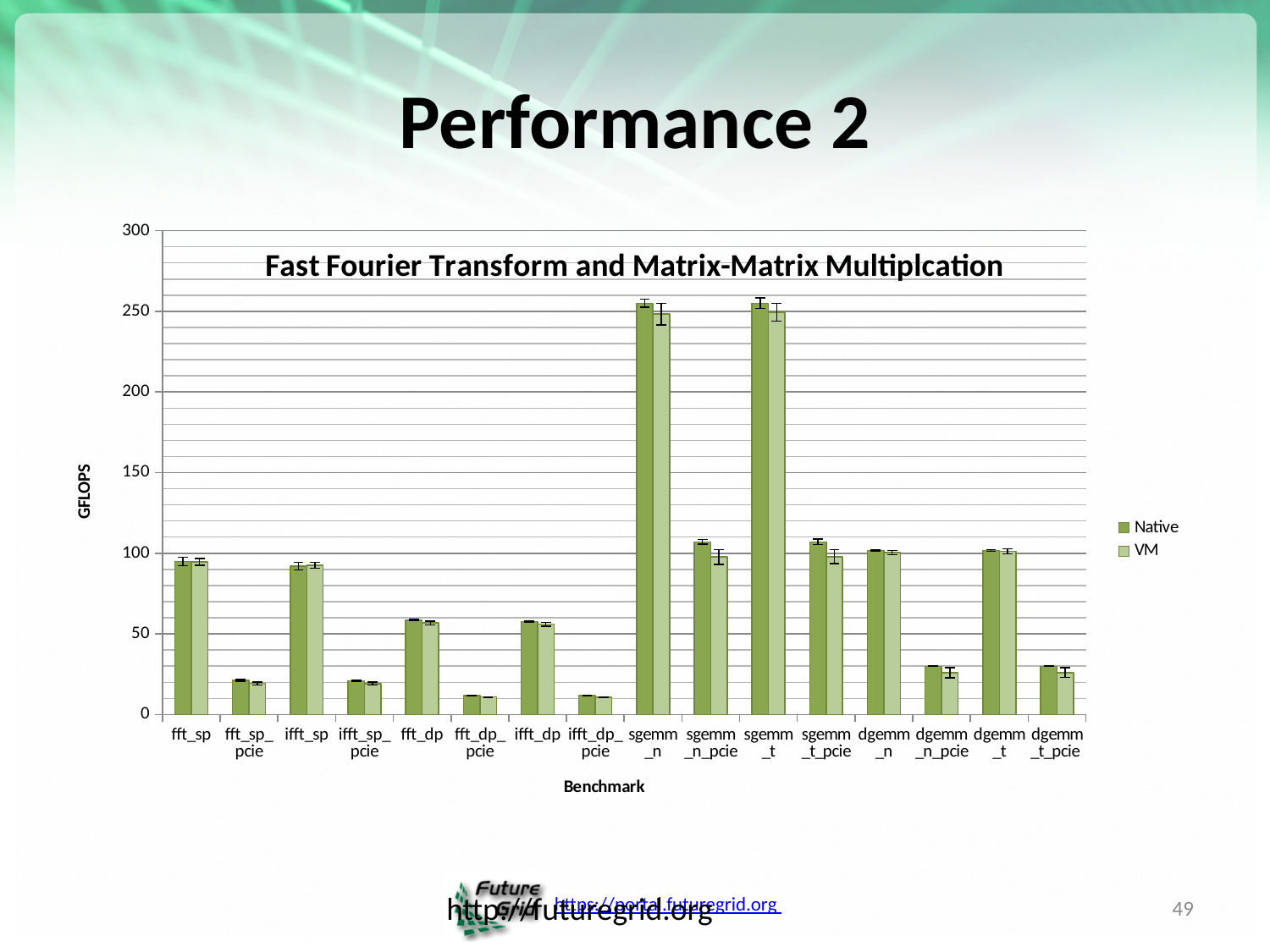
What kind of chart is shown on the slide? bar chart Is the VM value for fft_dp_pcie greater or less than 50? less Is the Native value for sgemm_n greater or less than 200? greater What is the label of the vertical axis? GFLOPS Is the Native value for fft_dp greater or less than 50? greater Which has the larger Native value, sgemm_n or fft_sp? sgemm_n What is the title of the chart? Fast Fourier Transform and Matrix-Matrix Multiplcation How many benchmark categories are shown on the x axis? 16 Which has the larger VM value, fft_sp or fft_sp_pcie? fft_sp How many series does the legend list? 2